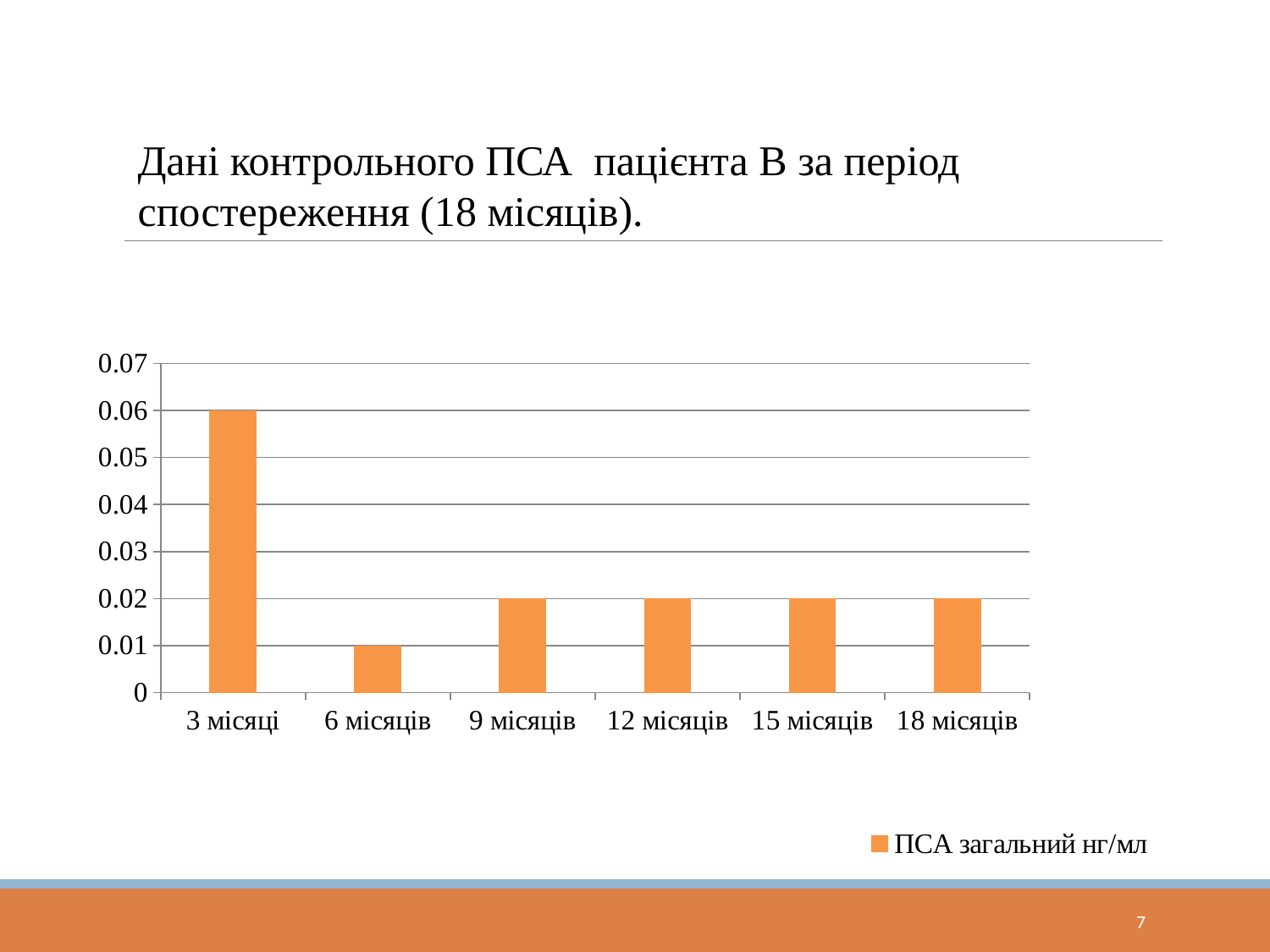
What is the value for 3 місяці? 0.06 Which category has the lowest value? 6 місяців Which is larger, the value for 3 місяці or the value for 18 місяців? 3 місяці What is the value for 12 місяців? 0.02 How many categories are shown on the x axis? 6 What is the value for 6 місяців? 0.01 What is the legend entry for the series shown? ПСА загальний нг/мл Is the value for 3 місяці greater or less than 0.05? greater What is the difference between the values for 3 місяці and 6 місяців? 0.05 Which category has the highest value? 3 місяці What is the difference between the values for 9 місяців and 6 місяців? 0.01 What kind of chart is shown on the slide? bar chart